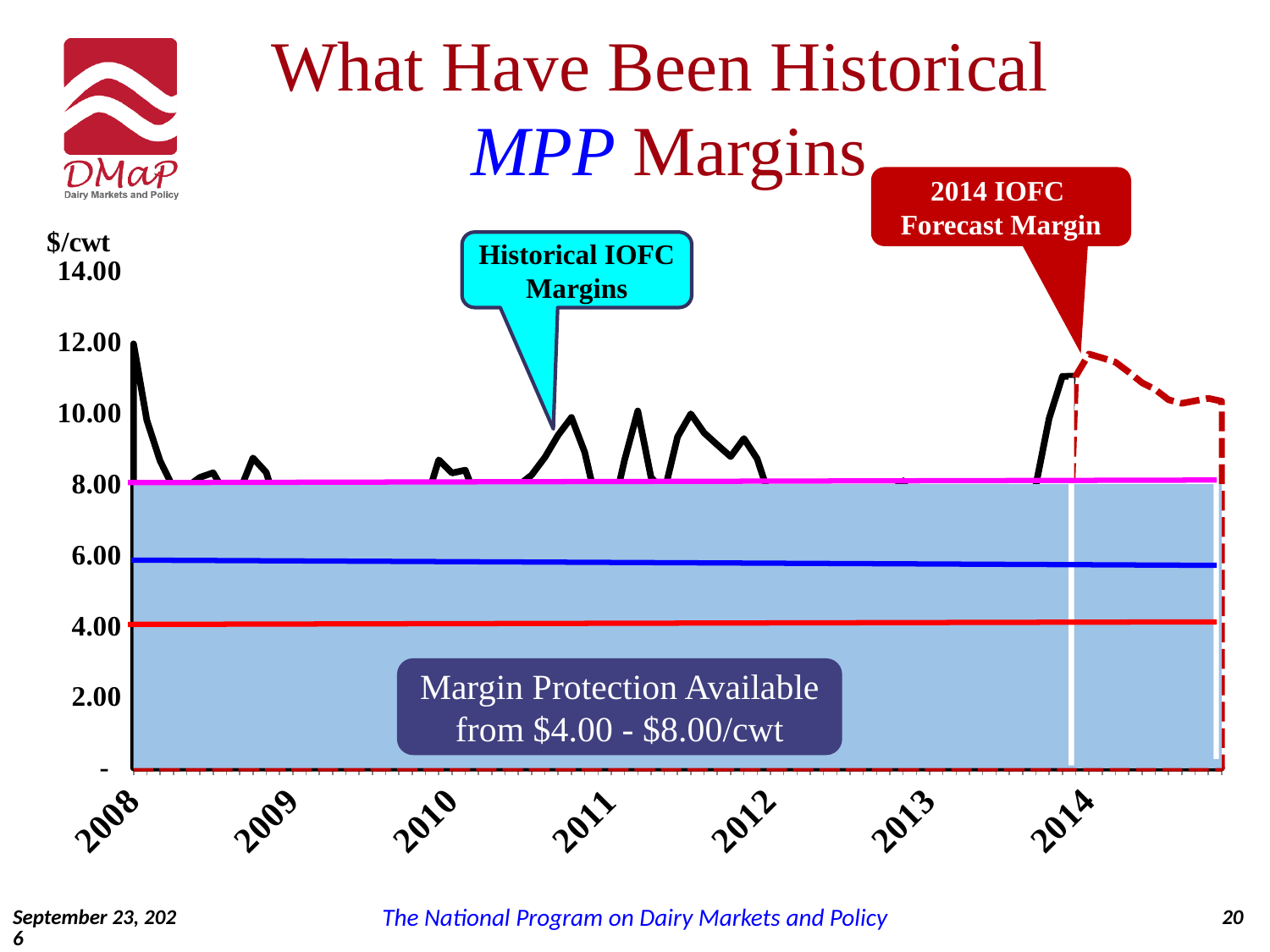
What does the red dashed line at the right of the chart represent? 2014 IOFC Forecast Margin Is the 2014 IOFC forecast margin at the end of 2014 greater or less than 8.00? greater From the start of 2008 to the start of 2009, does the historical IOFC margin rise or fall? fall Is the peak of the historical IOFC margin in 2011 greater or less than 12.00? less Which is higher: the historical IOFC margin peak at the start of 2008 or the peak in 2011? start of 2008 At what value on the y axis does the red horizontal line sit? 4.00 What is the title of the chart on the slide? What Have Been Historical MPP Margins Is the historical IOFC margin at the start of 2008 greater or less than 10.00? greater At what value on the y axis does the magenta horizontal line sit? 8.00 How many years are labeled on the x axis of the chart? 7 What kind of chart is shown on the slide? line chart